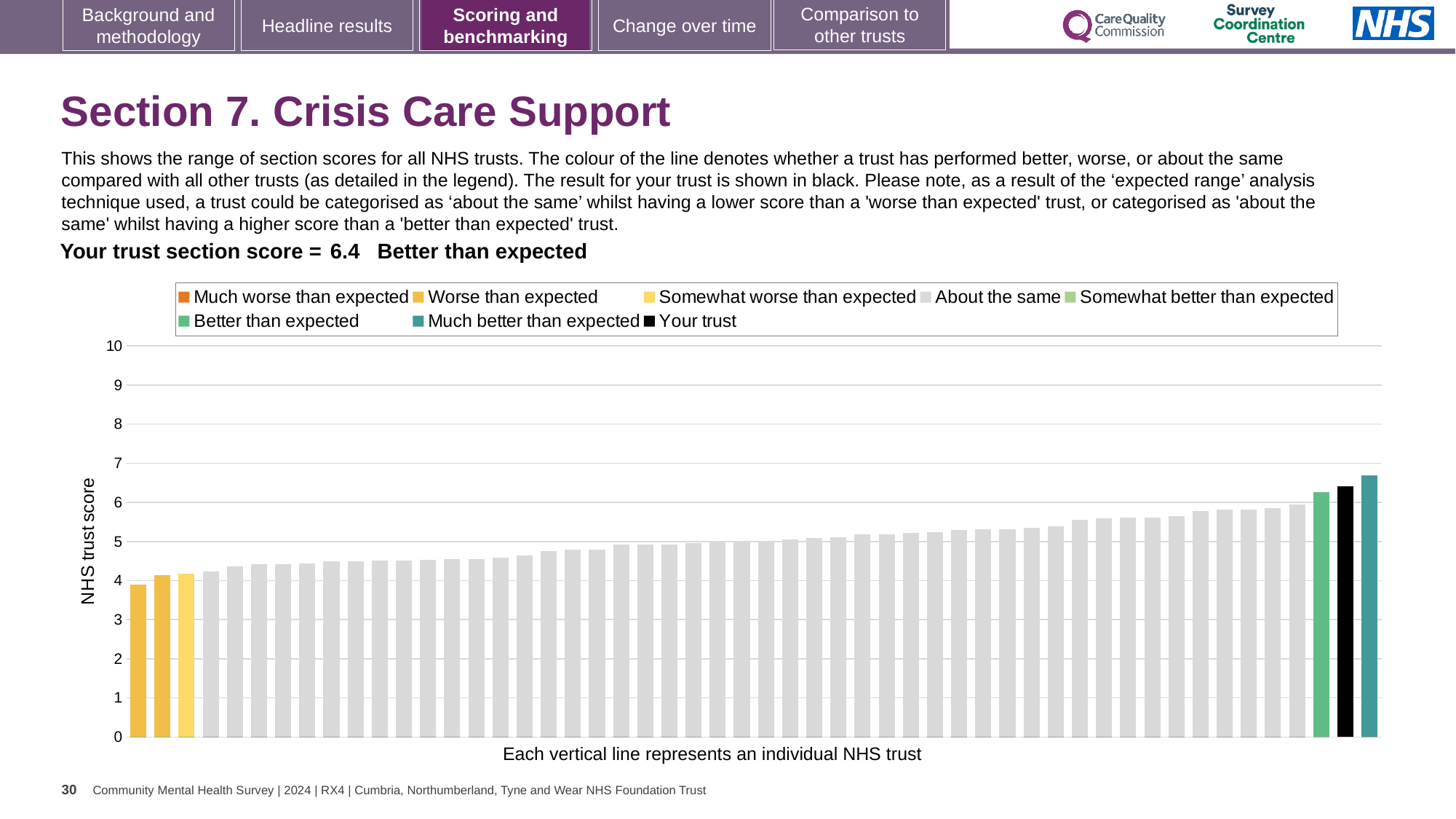
What colour is the bar representing your trust? black Which legend category does the lowest bar on the chart belong to? Worse than expected Which legend category does the highest bar on the chart belong to? Much better than expected Is the value of the black 'Your trust' bar greater or less than 7? less Is the value of the black 'Your trust' bar greater or less than 6? greater How many categories does the chart legend list? 8 What kind of chart is shown on the slide? bar chart What is the section score for your trust shown on the slide? 6.4 Is the value of the highest bar on the chart greater or less than 7? less Do the bar values rise or fall from left to right along the x axis? rise What is the label on the vertical axis of the chart? NHS trust score